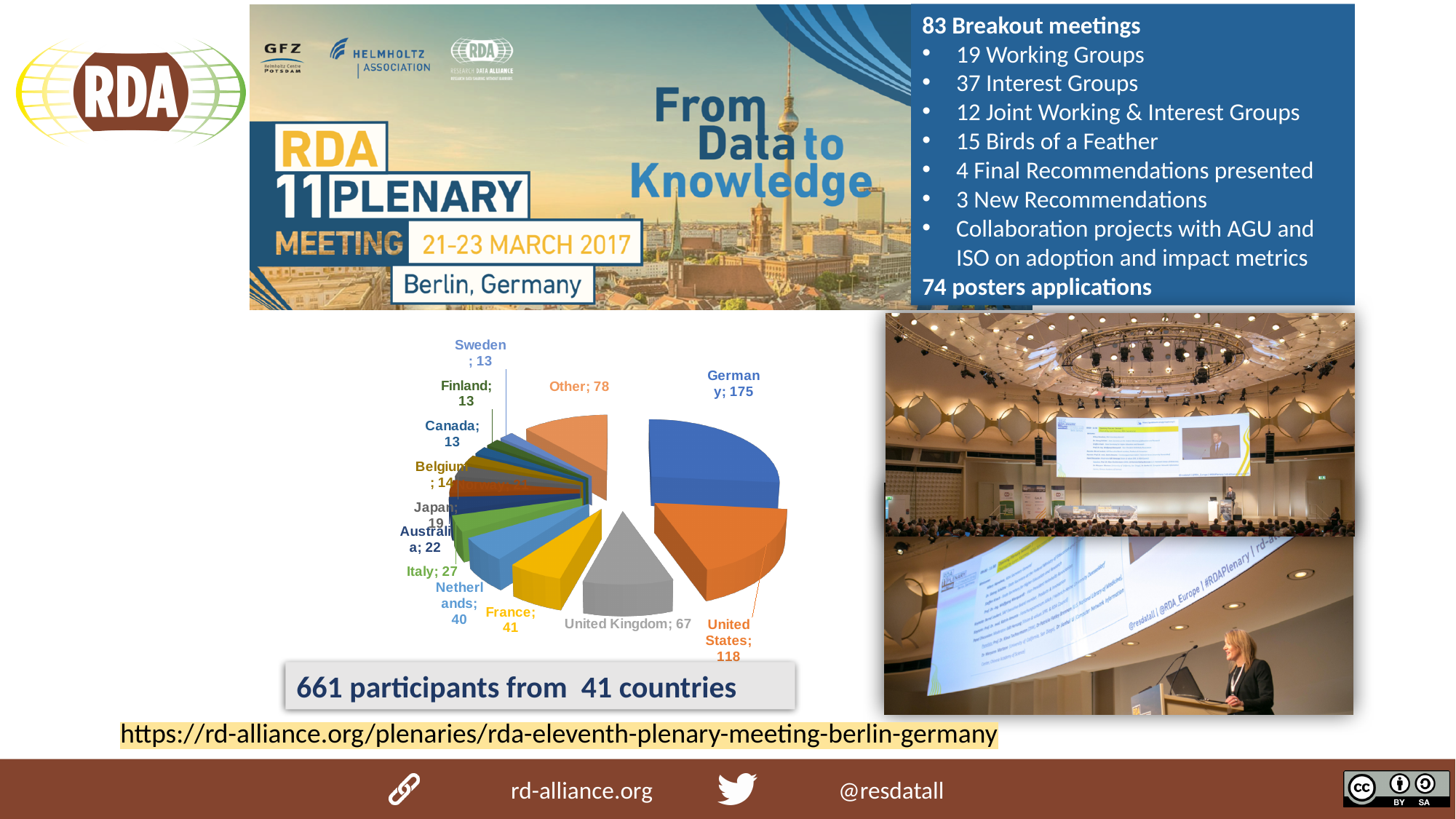
What kind of chart is shown on the slide? pie chart What is the value for Italy in the pie chart? 27 How many participants came from Germany according to the pie chart? 175 What is the difference between the values for the United Kingdom and France in the pie chart? 26 What is the value for the Netherlands in the pie chart? 40 What is the value for the United Kingdom in the pie chart? 67 What is the difference between the values for Germany and the United States in the pie chart? 57 Which country has the largest slice in the pie chart? Germany According to the caption below the pie chart, how many participants from how many countries attended? 661 participants from 41 countries What is the value for the 'Other' slice in the pie chart? 78 Which has a larger value in the pie chart, Australia or Japan? Australia How many participants came from the United States according to the pie chart? 118